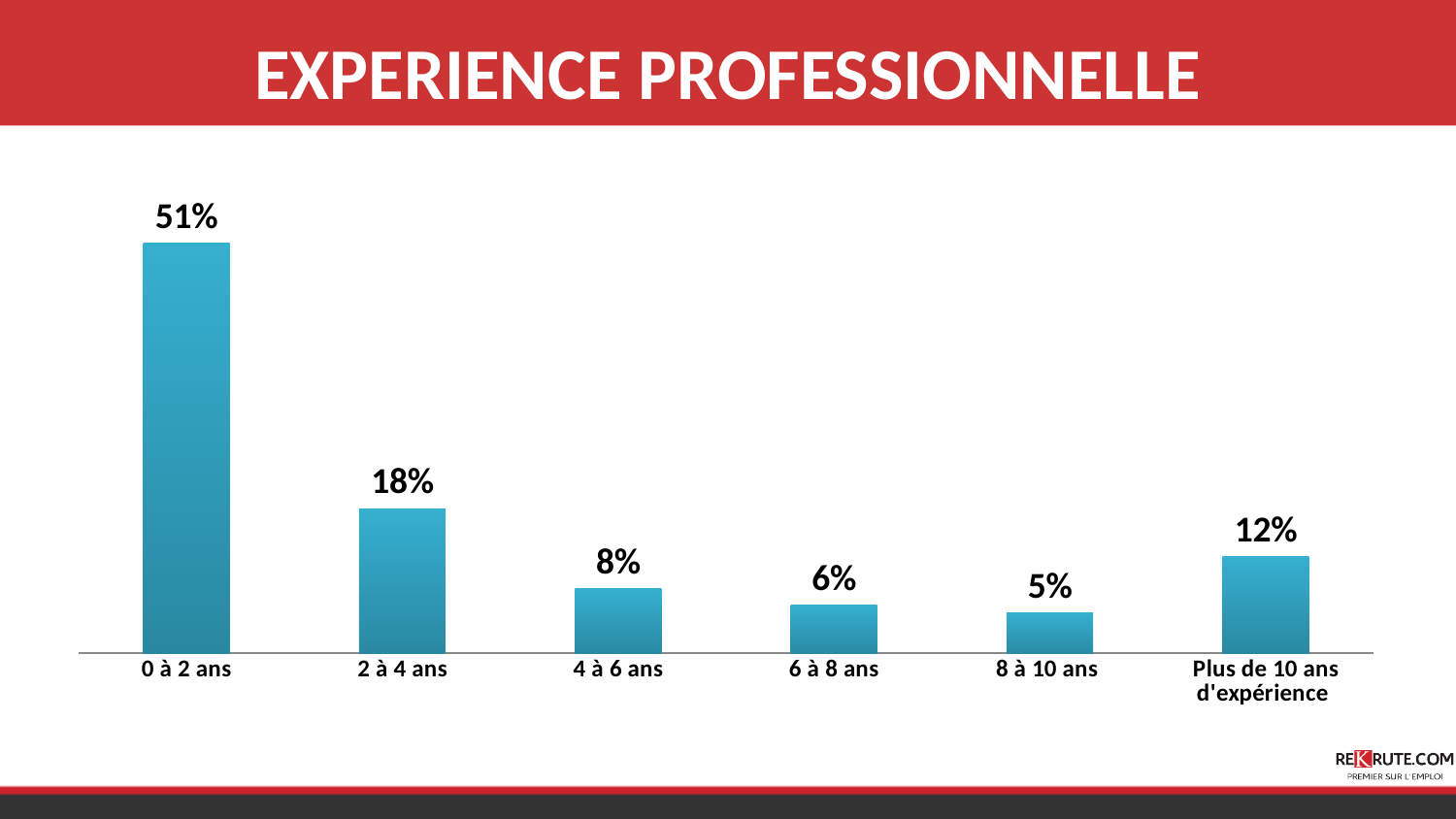
Which is larger: the value for '4 à 6 ans' or for 'Plus de 10 ans d'expérience'? Plus de 10 ans d'expérience What is the difference between the values for '0 à 2 ans' and '2 à 4 ans'? 33% What kind of chart is shown on the slide? Bar chart What percentage is shown for 'Plus de 10 ans d'expérience'? 12% How many categories are shown on the x axis? 6 What percentage is shown for the '0 à 2 ans' category? 51% Which category has the highest value? 0 à 2 ans What is the value for '2 à 4 ans'? 18% Which category has the lowest value? 8 à 10 ans What is the title of the slide? EXPERIENCE PROFESSIONNELLE What is the difference between '4 à 6 ans' and '6 à 8 ans'? 2% What is the value for '8 à 10 ans'? 5%